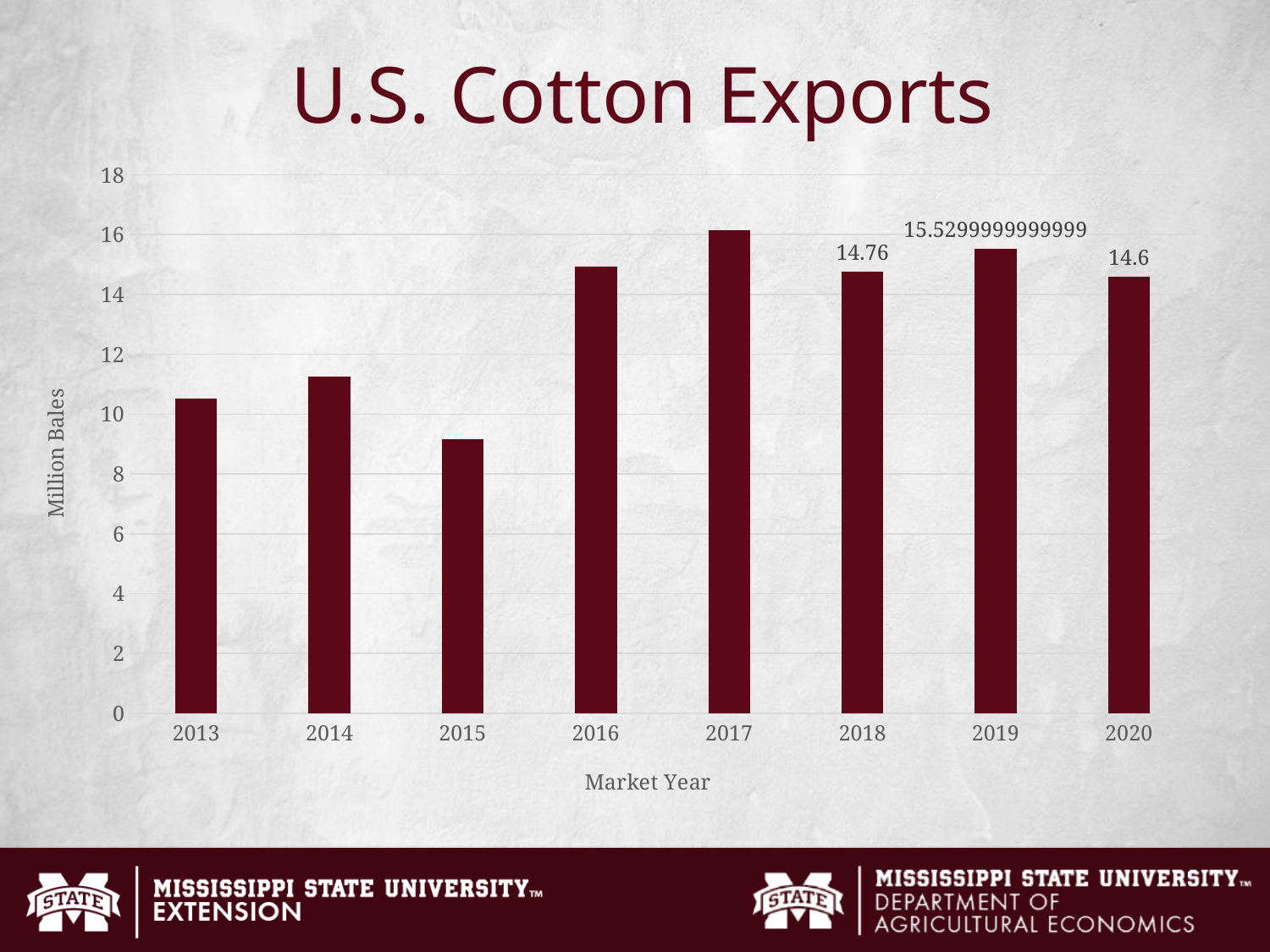
What is the label on the y axis? Million Bales How many market years are shown on the x axis? 8 Is the value for 2017 greater or less than 16? greater What kind of chart is shown on the slide? bar chart Is the value for 2015 greater or less than 10? less What is the value shown for 2019? 15.5299999999999 What is the value for 2020? 14.6 What is the value for 2018? 14.76 Which market year has the highest cotton exports? 2017 Which market year has the lowest cotton exports? 2015 Which is larger, the value for 2018 or the value for 2020? 2018 What is the difference between the values for 2018 and 2020? 0.16